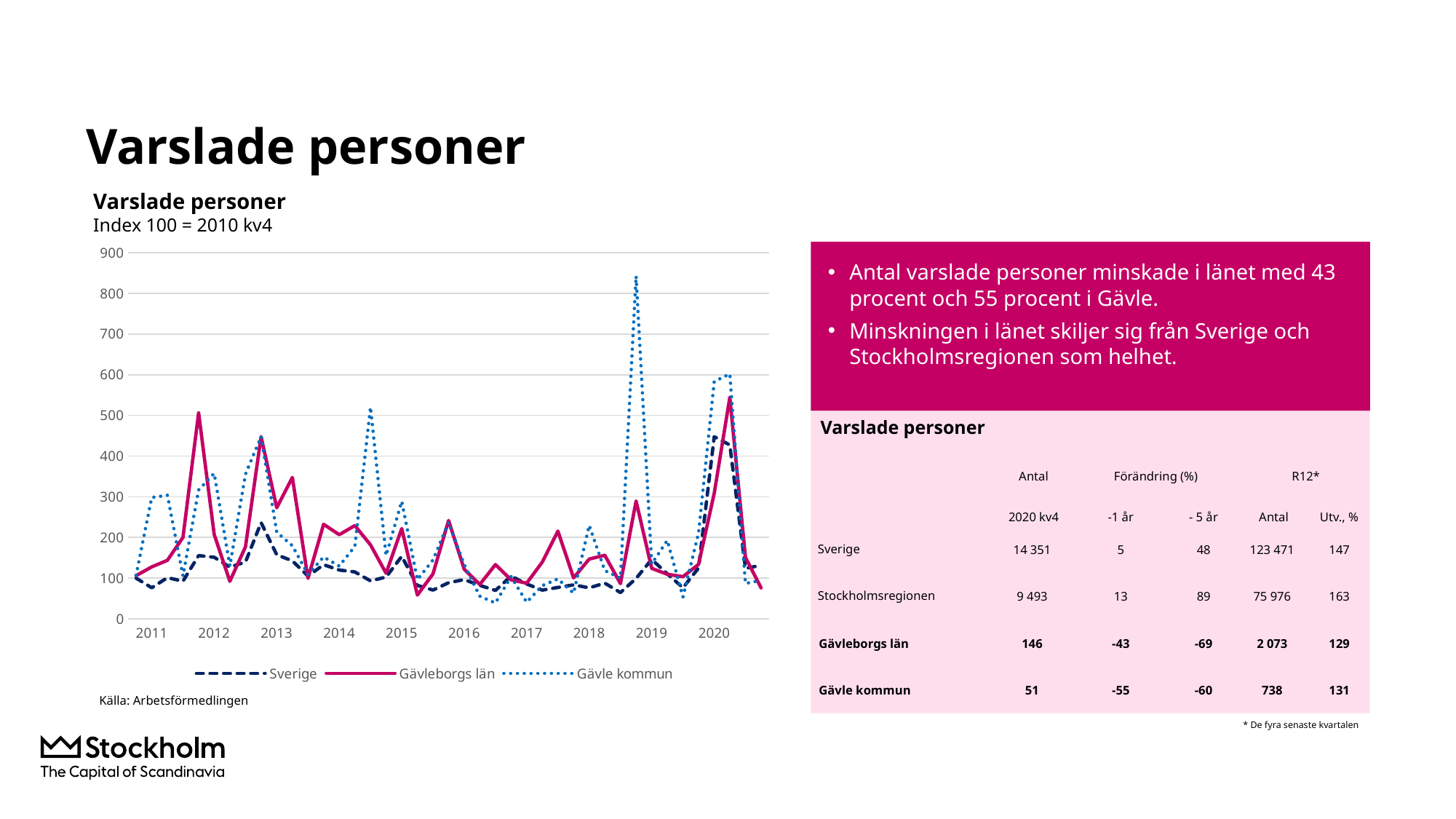
What are the three series shown in the chart legend? Sverige, Gävleborgs län, Gävle kommun How many series does the chart legend list? 3 What is the highest value shown on the y axis of the chart? 900 Is the 2020 peak of the Sverige line greater or less than 400? greater At the 2019 peak, which series is higher: Gävle kommun or Gävleborgs län? Gävle kommun Is the 2020 peak of the Gävleborgs län line greater or less than 500? greater Is the highest peak of the Gävle kommun line (in 2019) greater or less than 800? greater What is the index base stated in the chart subtitle? Index 100 = 2010 kv4 What kind of chart is shown on the slide? Line chart Which series reaches the highest value anywhere on the chart? Gävle kommun How many year labels are shown on the x axis of the chart? 10